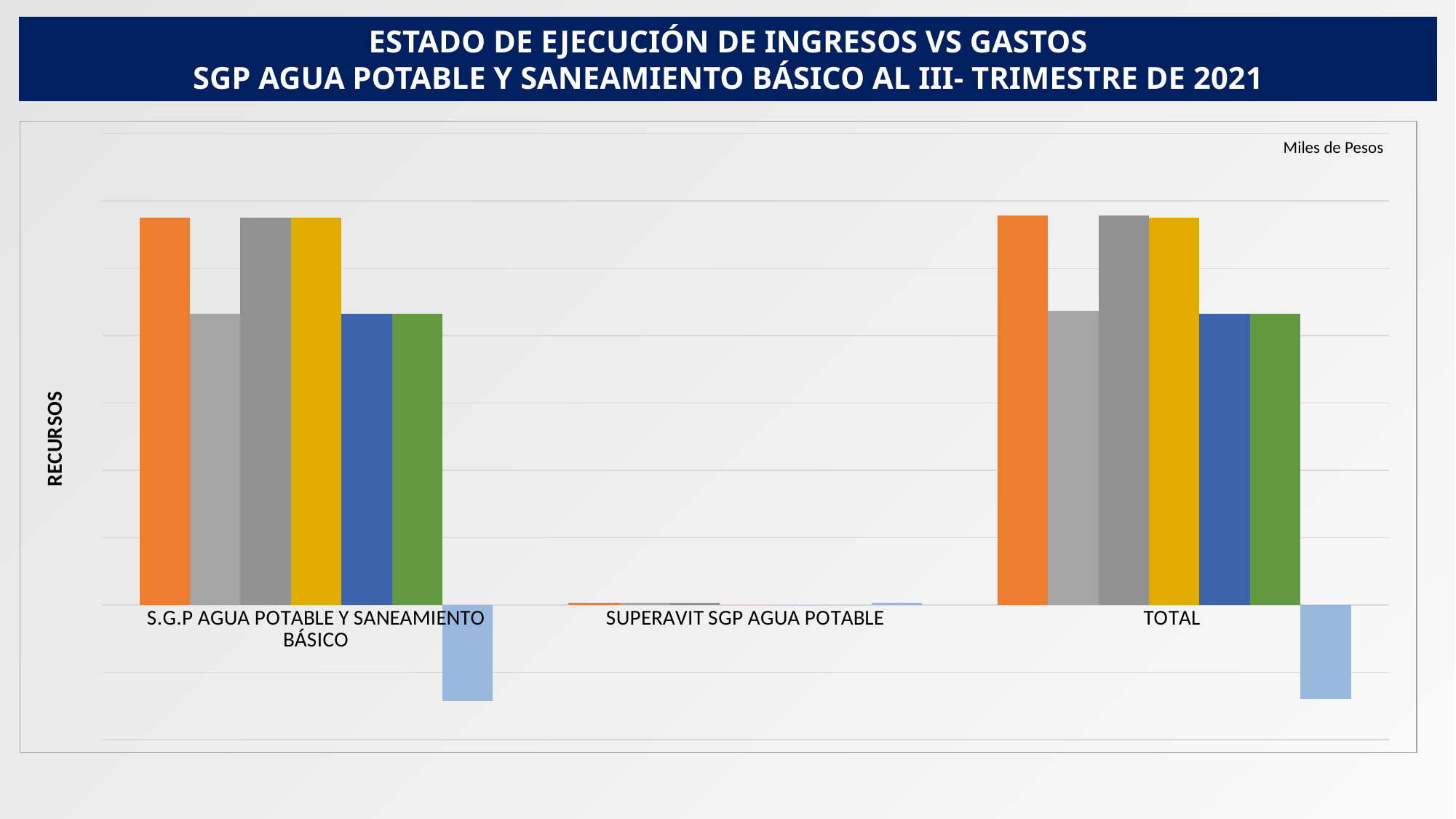
How many bars are plotted for the TOTAL category? 7 Are the bars for SUPERAVIT SGP AGUA POTABLE larger or smaller than the bars for TOTAL? Smaller How many categories are shown on the x axis of the chart? 3 In the TOTAL category, is the light blue bar above or below the horizontal axis? Below What is the label of the vertical axis of the chart? RECURSOS In the S.G.P AGUA POTABLE Y SANEAMIENTO BÁSICO category, is the orange bar taller or shorter than the light gray bar next to it? Taller What kind of chart is shown on the slide? Bar chart In the TOTAL category, is the blue bar taller or shorter than the gold bar? Shorter Which category has the smallest bars in the chart? SUPERAVIT SGP AGUA POTABLE What is the title of the chart on the slide? ESTADO DE EJECUCIÓN DE INGRESOS VS GASTOS SGP AGUA POTABLE Y SANEAMIENTO BÁSICO AL III- TRIMESTRE DE 2021